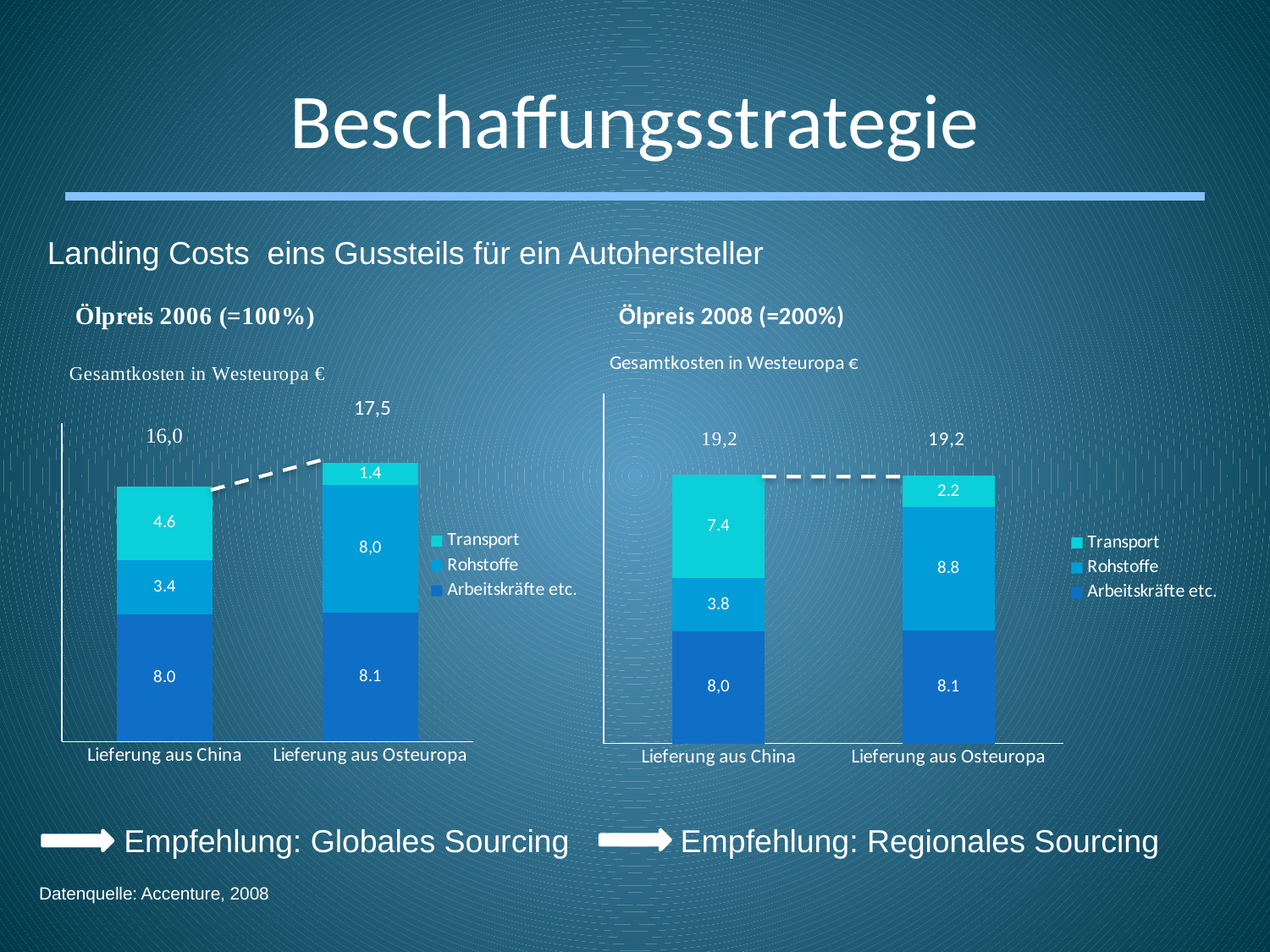
How many series does the legend of the 'Ölpreis 2008 (=200%)' chart list? 3 In the 'Ölpreis 2008 (=200%)' chart, what is the Transport value for Lieferung aus China? 7.4 In the 'Ölpreis 2006 (=100%)' chart, what is the Rohstoffe value for Lieferung aus Osteuropa? 8,0 In the 'Ölpreis 2006 (=100%)' chart, what is the Transport value for Lieferung aus China? 4.6 How many categories are shown on the x axis of the 'Ölpreis 2006 (=100%)' chart? 2 In the 'Ölpreis 2006 (=100%)' chart, which category has the higher total, Lieferung aus China or Lieferung aus Osteuropa? Lieferung aus Osteuropa In the 'Ölpreis 2008 (=200%)' chart, what is the Rohstoffe value for Lieferung aus Osteuropa? 8.8 What kind of chart is the 'Ölpreis 2006 (=100%)' chart? Stacked bar chart In the 'Ölpreis 2006 (=100%)' chart, what is the total shown above the Lieferung aus Osteuropa bar? 17,5 In the 'Ölpreis 2006 (=100%)' chart, what is the difference between the Transport values for Lieferung aus China and Lieferung aus Osteuropa? 3.2 In the 'Ölpreis 2008 (=200%)' chart, what is the difference between the Rohstoffe values for Lieferung aus Osteuropa and Lieferung aus China? 5.0 In the 'Ölpreis 2008 (=200%)' chart, what is the total shown above the Lieferung aus China bar? 19,2